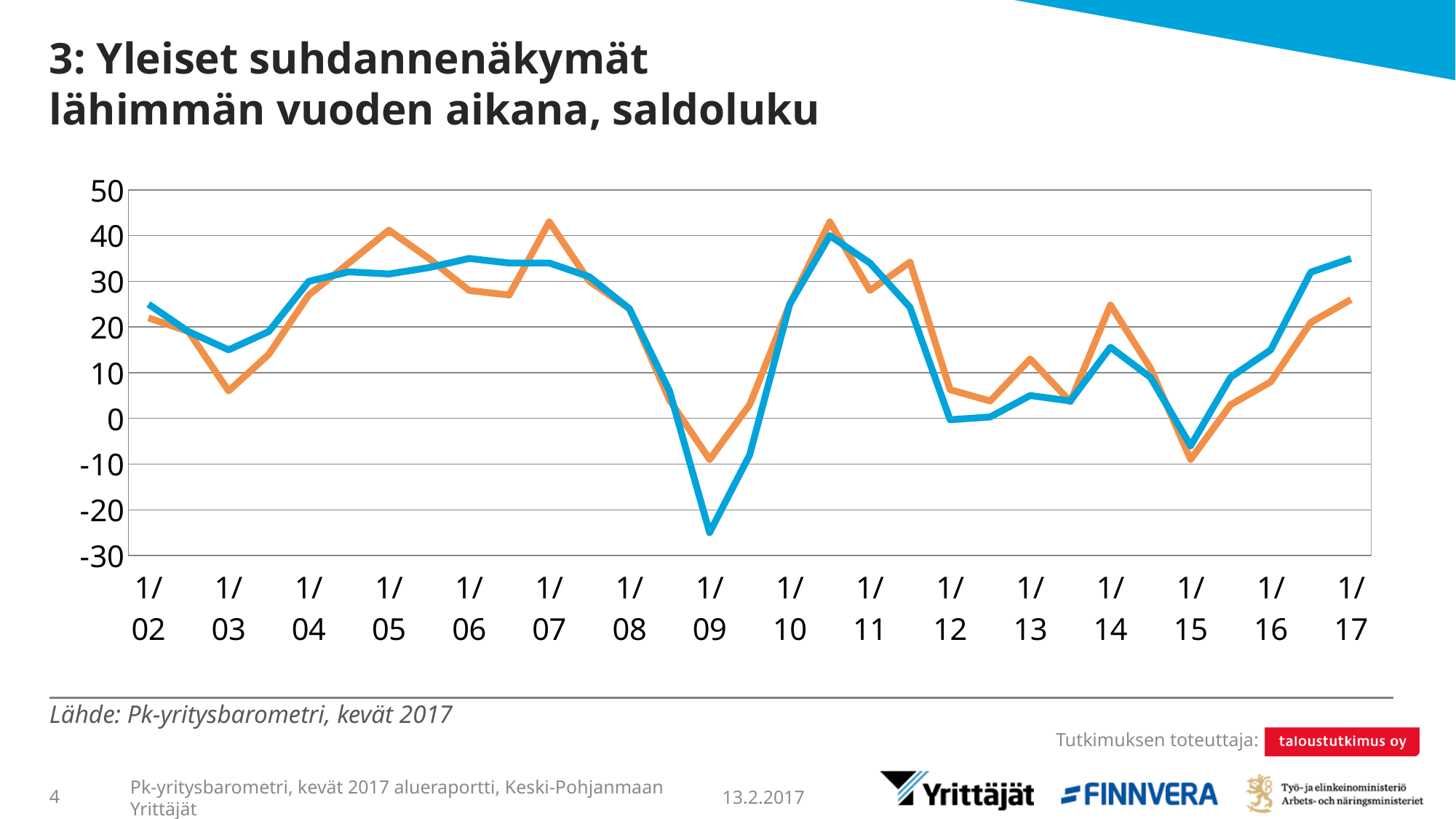
What kind of chart is shown on the slide? line chart Do the lines rise or fall between 1/15 and 1/17? rise How many lines are plotted on the chart? 2 Is the value of the blue line at 1/09 greater or less than -20? less At 1/05, which line has the higher value, the blue or the orange? orange At 1/17, which line has the higher value, the blue or the orange? blue Is the value of the orange line at 1/14 greater or less than 20? greater Is the value of the blue line at 1/17 greater or less than 30? greater At which x-axis label does the blue line reach its lowest value? 1/09 How many year labels are shown on the x axis? 16